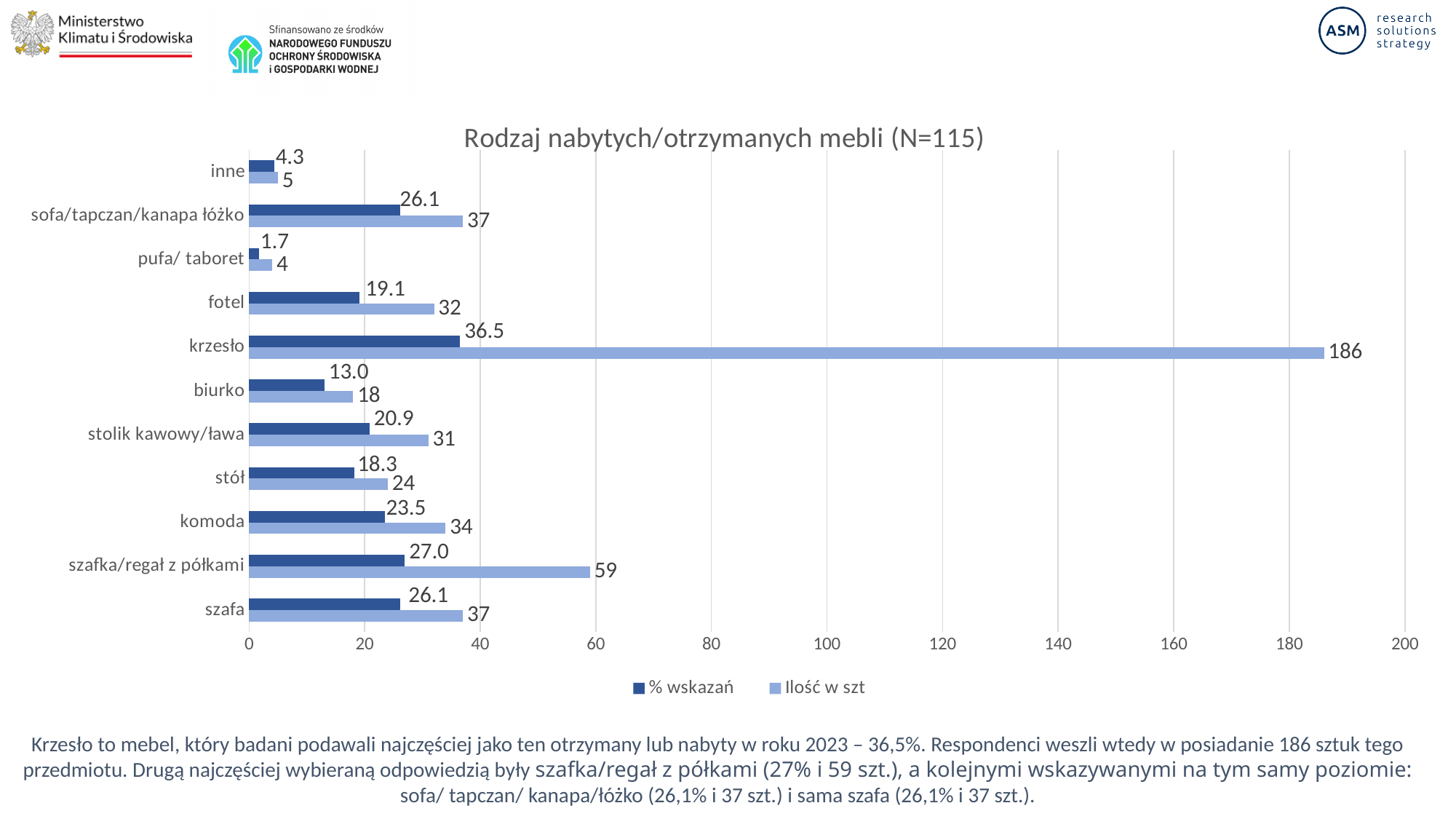
Which category has the lowest "Ilość w szt" value? pufa/ taboret Which category has the highest "% wskazań" value? krzesło How many categories are shown on the chart? 11 What is the "Ilość w szt" value for biurko? 18 How many series does the legend list? 2 What is the title of the chart? Rodzaj nabytych/otrzymanych mebli (N=115) What kind of chart is shown on the slide? bar chart What is the "Ilość w szt" value for krzesło? 186 What is the "% wskazań" value for szafka/regał z półkami? 27.0 Is the "Ilość w szt" value for krzesło greater or less than 180? greater What is the difference between the "Ilość w szt" values for szafka/regał z półkami and komoda? 25 Which has a larger "Ilość w szt" value, fotel or stół? fotel